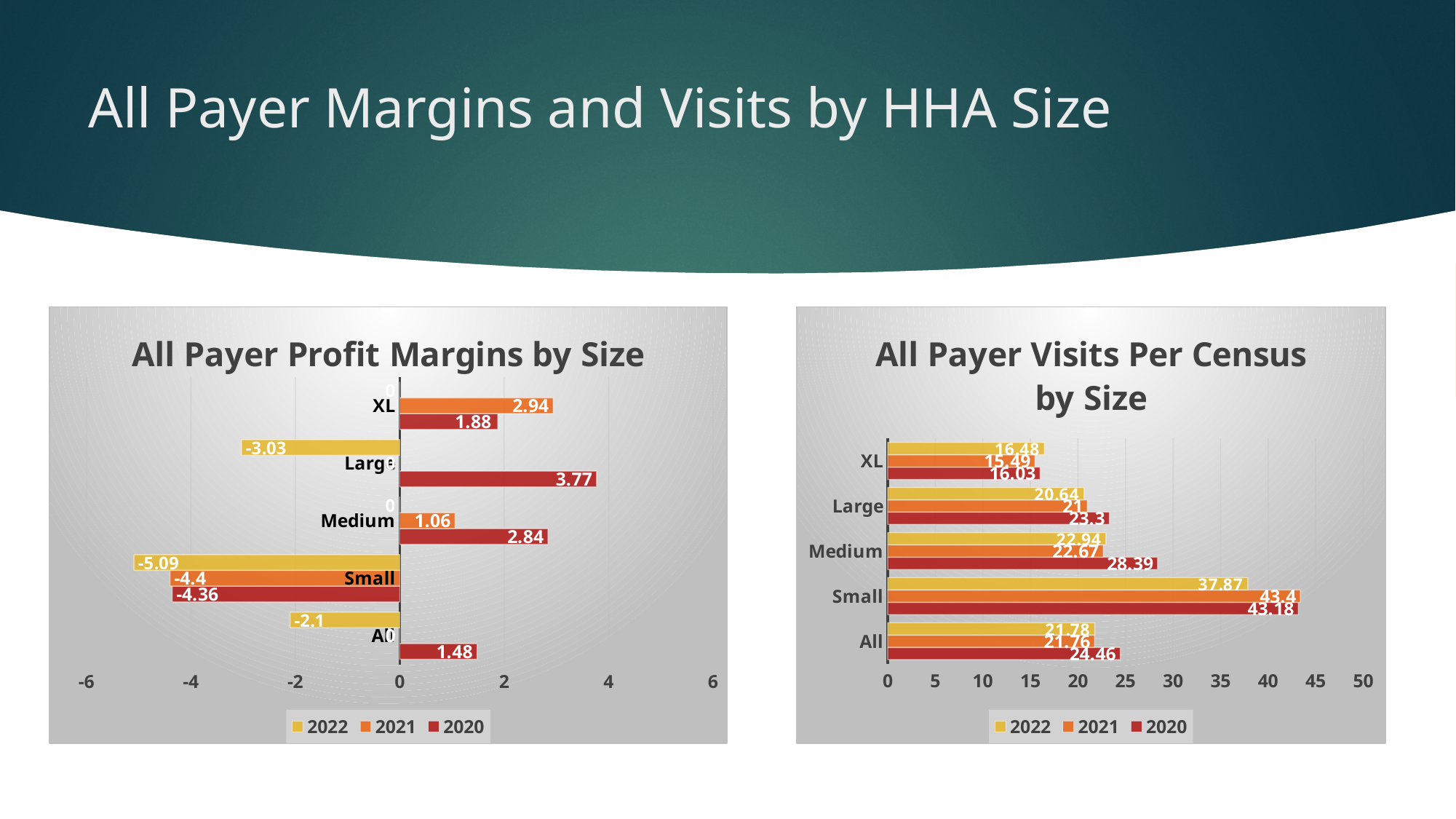
In the All Payer Profit Margins by Size chart, what is the 2020 value for Large? 3.77 In the All Payer Visits Per Census by Size chart, how many size categories are shown? 5 What kind of chart is the All Payer Visits Per Census by Size chart? bar chart In the All Payer Visits Per Census by Size chart, is the 2020 value for Large larger or smaller than the 2020 value for XL? larger In the All Payer Profit Margins by Size chart, what is the 2022 value for Small? -5.09 In the All Payer Profit Margins by Size chart, what is the 2021 value for XL? 2.94 In the All Payer Profit Margins by Size chart, which size category has the lowest 2020 value? Small In the All Payer Visits Per Census by Size chart, which size category has the highest 2021 value? Small In the All Payer Visits Per Census by Size chart, what is the 2022 value for Small? 37.87 In the All Payer Profit Margins by Size chart, how many series does the legend list? 3 In the All Payer Visits Per Census by Size chart, what is the 2020 value for Medium? 28.39 In the All Payer Profit Margins by Size chart, what is the difference between the 2020 values for Medium and XL? 0.96